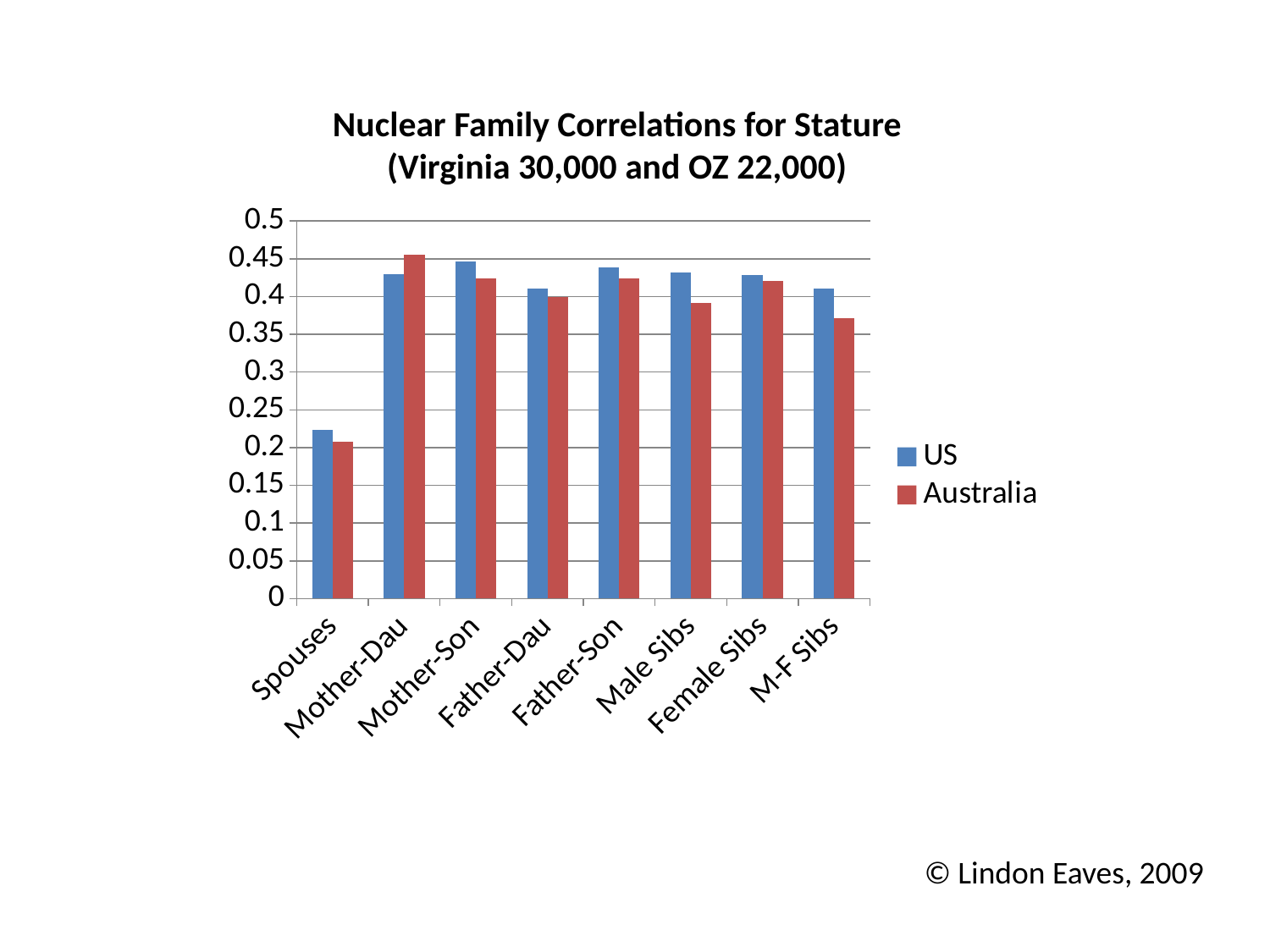
Which category has the lowest Australia correlation? Spouses Which category has the highest Australia correlation? Mother-Dau How many family relationship categories are shown on the x axis? 8 What kind of chart is shown on the slide? bar chart Which series is shown in red? Australia Is the US value for Mother-Son greater or less than 0.4? greater For Mother-Dau, which is larger, the US or the Australia correlation? Australia For Male Sibs, which is larger, the US or the Australia correlation? US Which category has the lowest US correlation? Spouses Is the US value for Spouses greater or less than 0.25? less How many series does the legend list? 2 Is the Australia value for M-F Sibs greater or less than 0.4? less